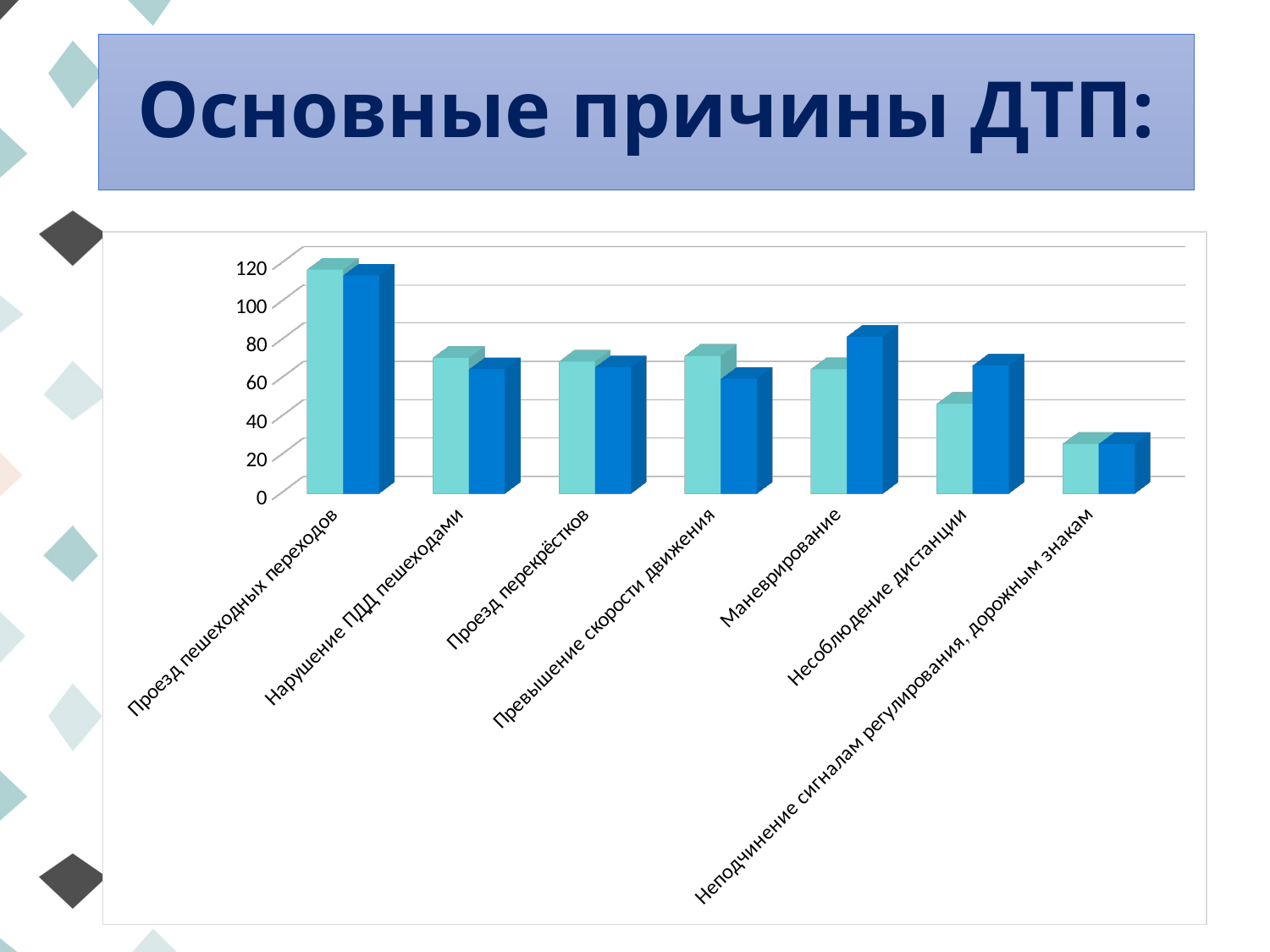
Is the dark-blue bar for Маневрирование greater or less than 60? greater Is the light-blue bar for Проезд пешеходных переходов greater or less than 100? greater Which is larger: the light-blue bar for Проезд пешеходных переходов or the light-blue bar for Маневрирование? Проезд пешеходных переходов Which category has the lowest dark-blue bar in the chart? Неподчинение сигналам регулирования, дорожным знакам Is the light-blue bar for Несоблюдение дистанции greater or less than 60? less What kind of chart is shown on the slide? Bar chart How many bars are plotted for each category in the chart? 2 What is the title of the slide containing the chart? Основные причины ДТП: For Маневрирование, which bar is taller: the light-blue bar or the dark-blue bar? the dark-blue bar Which category has the highest light-blue bar in the chart? Проезд пешеходных переходов How many categories are shown on the x axis of the chart? 7